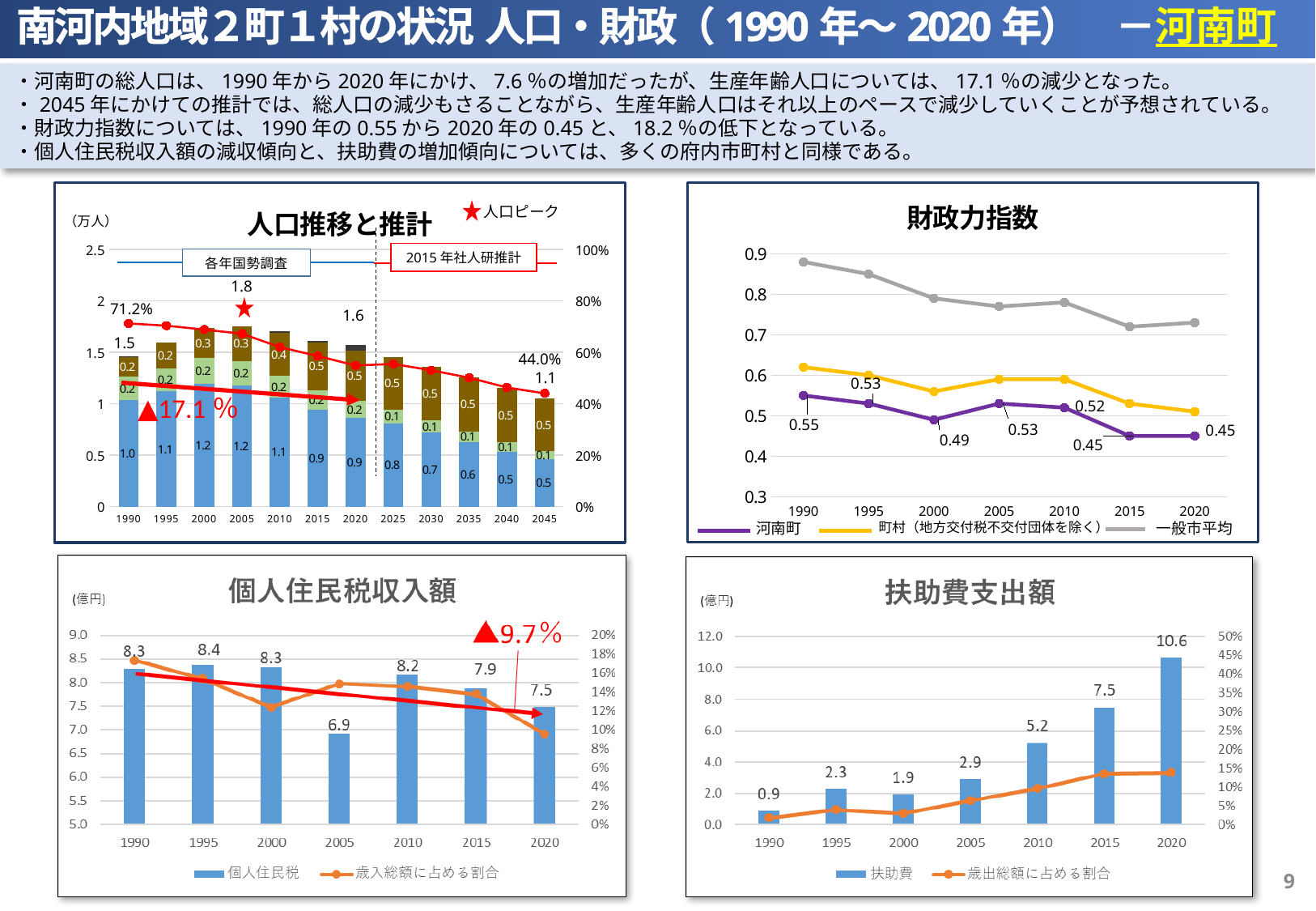
In the 扶助費支出額 chart, what is the value of 扶助費 for 2020? 10.6 In the 個人住民税収入額 chart, which year has the lowest 個人住民税 value? 2005 In the 扶助費支出額 chart, which year has the lowest 扶助費 value? 1990 In the 人口推移と推計 chart, what is the total population value labelled for 2045? 1.1 In the 個人住民税収入額 chart, what is the 個人住民税 value for 2020? 7.5 In the 財政力指数 chart, what is the value for 河南町 in 2000? 0.49 In the 扶助費支出額 chart, what is the difference between the 扶助費 values for 2020 and 2015? 3.1 In the 扶助費支出額 chart, do the 扶助費 bar values generally rise or fall from 1990 to 2020? rise In the 財政力指数 chart, how many series does the legend list? 3 In the 財政力指数 chart, is the 一般市平均 value for 1990 greater or less than 0.8? greater In the 個人住民税収入額 chart, which year has the highest 個人住民税 value? 1995 In the 個人住民税収入額 chart, how many years are shown on the x axis? 7